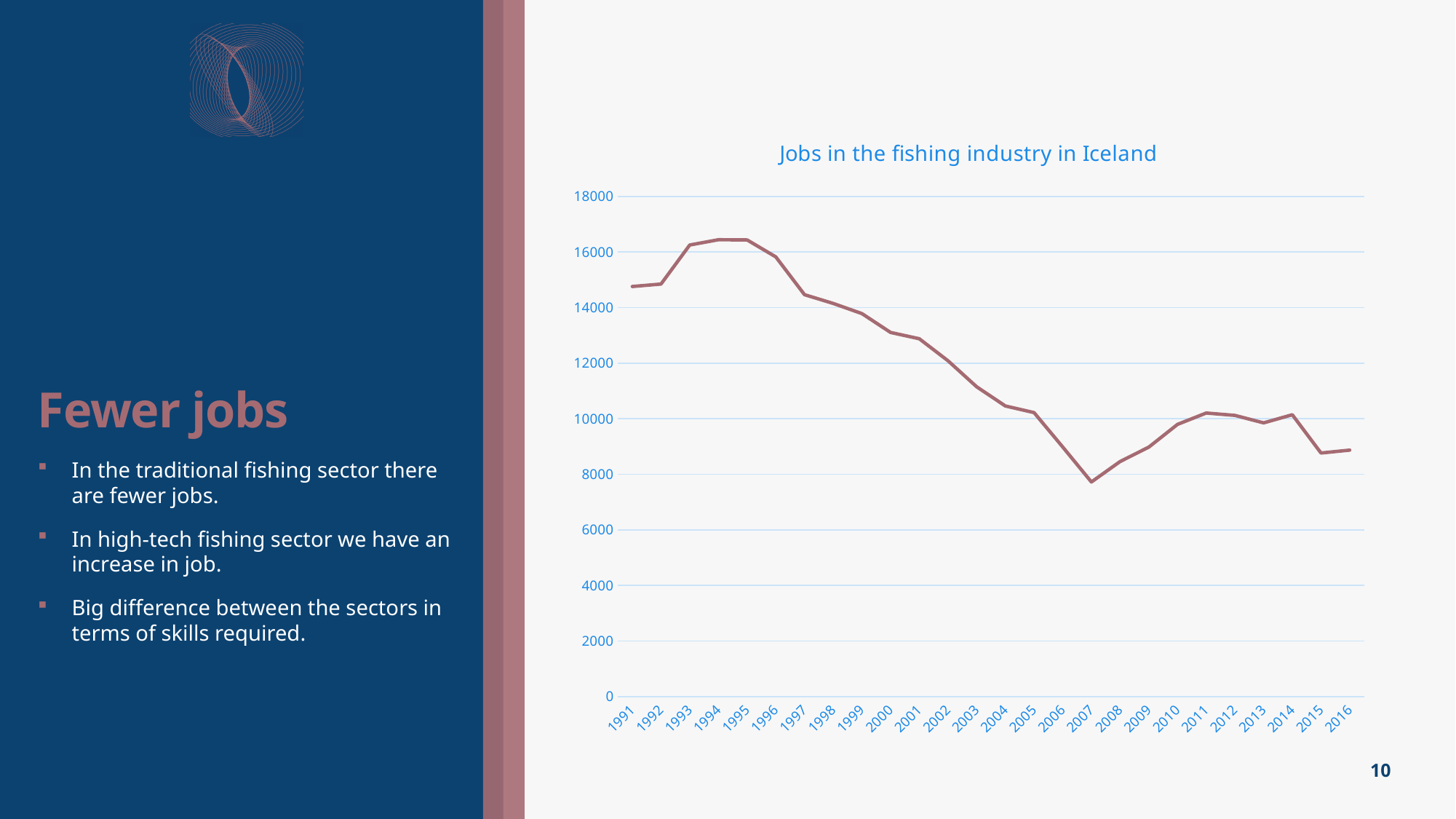
Is the value for 1993 greater or less than 16000? greater Which year has more jobs in the fishing industry, 1993 or 2016? 1993 What kind of chart is shown on the slide? line chart How many years are plotted on the x axis of the chart? 26 Is the value for 2016 greater or less than 10000? less Is the value for 2000 greater or less than 12000? greater Which year has the lowest number of jobs in the fishing industry in Iceland? 2007 Overall, do the number of jobs in the fishing industry rise or fall from 1991 to 2016? fall Which year has more jobs in the fishing industry, 2007 or 2011? 2011 What is the title of the chart? Jobs in the fishing industry in Iceland